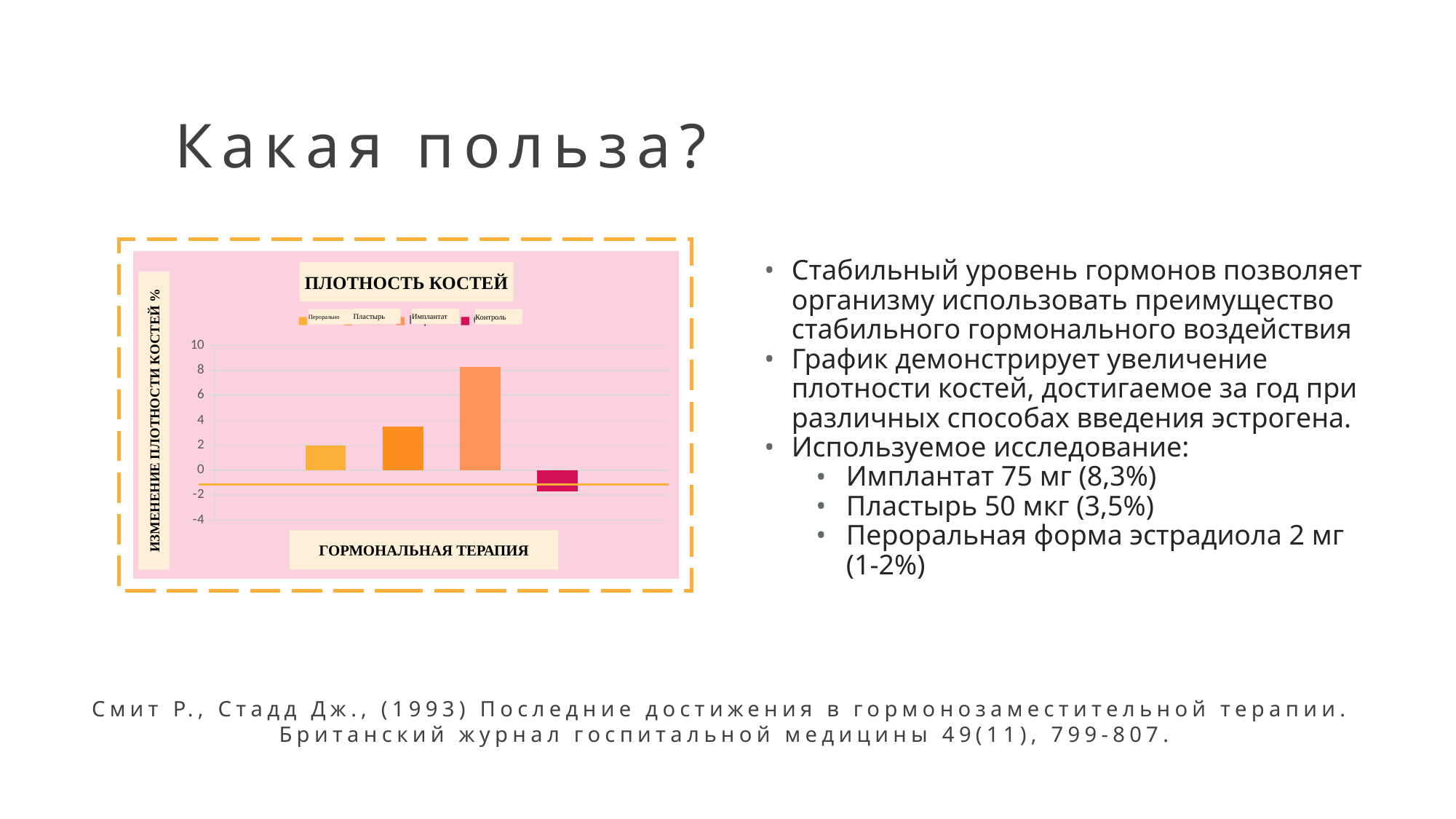
How many bars are plotted in the chart? 4 Which is larger, the bar for Имплантат or the bar for Пластырь? Имплантат How many series does the chart legend list? 4 What is the title of the chart? ПЛОТНОСТЬ КОСТЕЙ What kind of chart is shown on the slide? bar chart Is the value for Контроль greater or less than 0? less Is the value for Имплантат greater or less than 6? greater Which series has the highest bar in the chart? Имплантат Which is larger, the bar for Пластырь or the bar for Перорально? Пластырь Which series has the lowest bar in the chart? Контроль What is the label on the vertical axis of the chart? ИЗМЕНЕНИЕ ПЛОТНОСТИ КОСТЕЙ % Is the value for Пластырь greater or less than 2? greater